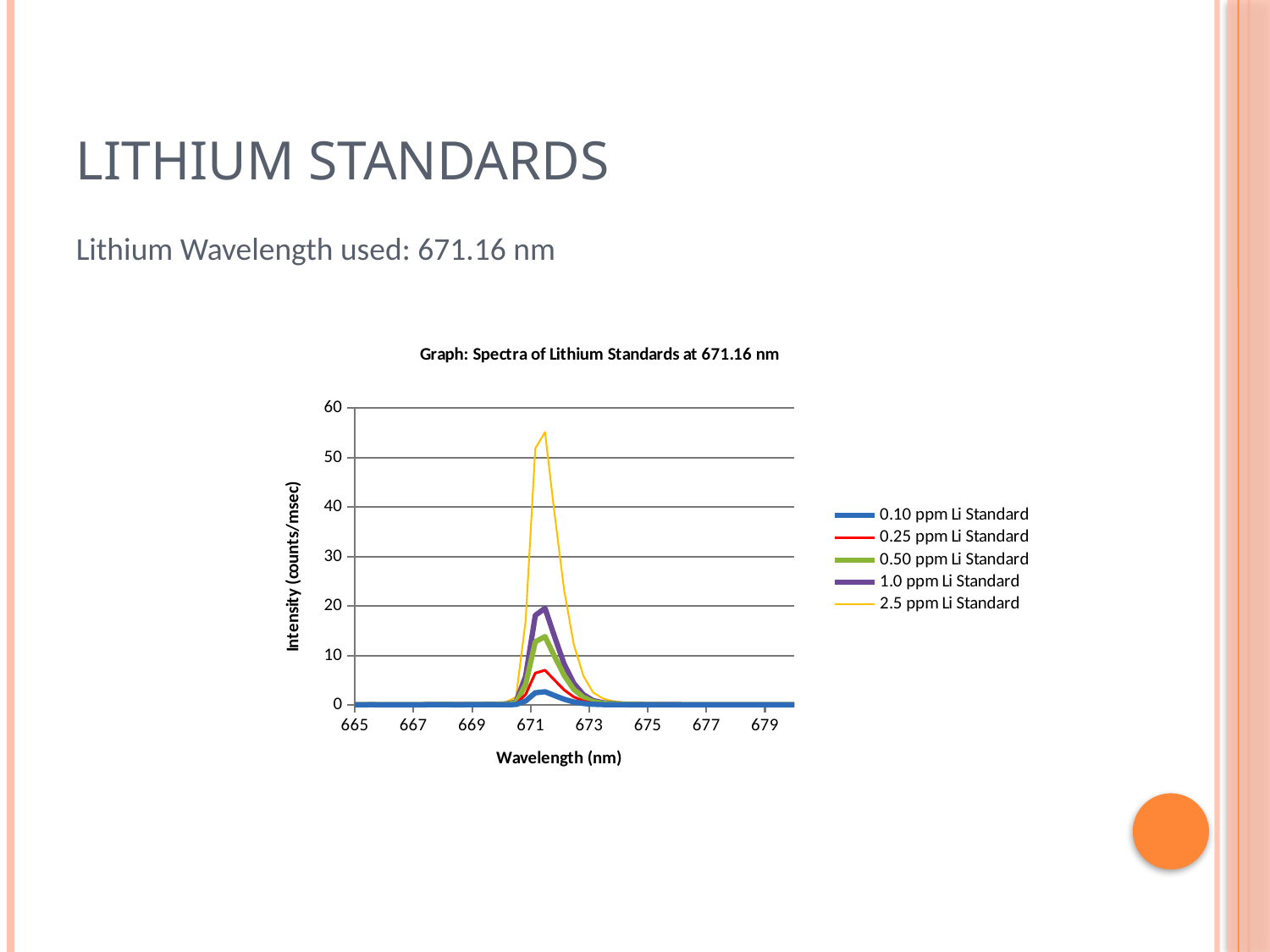
What is the title of the chart? Graph: Spectra of Lithium Standards at 671.16 nm Is the peak value for the 2.5 ppm Li Standard greater or less than 50? greater Which series has the lowest peak intensity? 0.10 ppm Li Standard Which series has a higher peak, the 0.25 ppm Li Standard or the 0.10 ppm Li Standard? 0.25 ppm Li Standard Is the peak value for the 0.25 ppm Li Standard greater or less than 10? less What kind of chart is shown on the slide? line chart Which series reaches the highest peak intensity? 2.5 ppm Li Standard Is the peak value for the 1.0 ppm Li Standard greater or less than 30? less How many series does the legend list? 5 What is the label of the y axis? Intensity (counts/msec) Which series has a higher peak, the 1.0 ppm Li Standard or the 0.50 ppm Li Standard? 1.0 ppm Li Standard